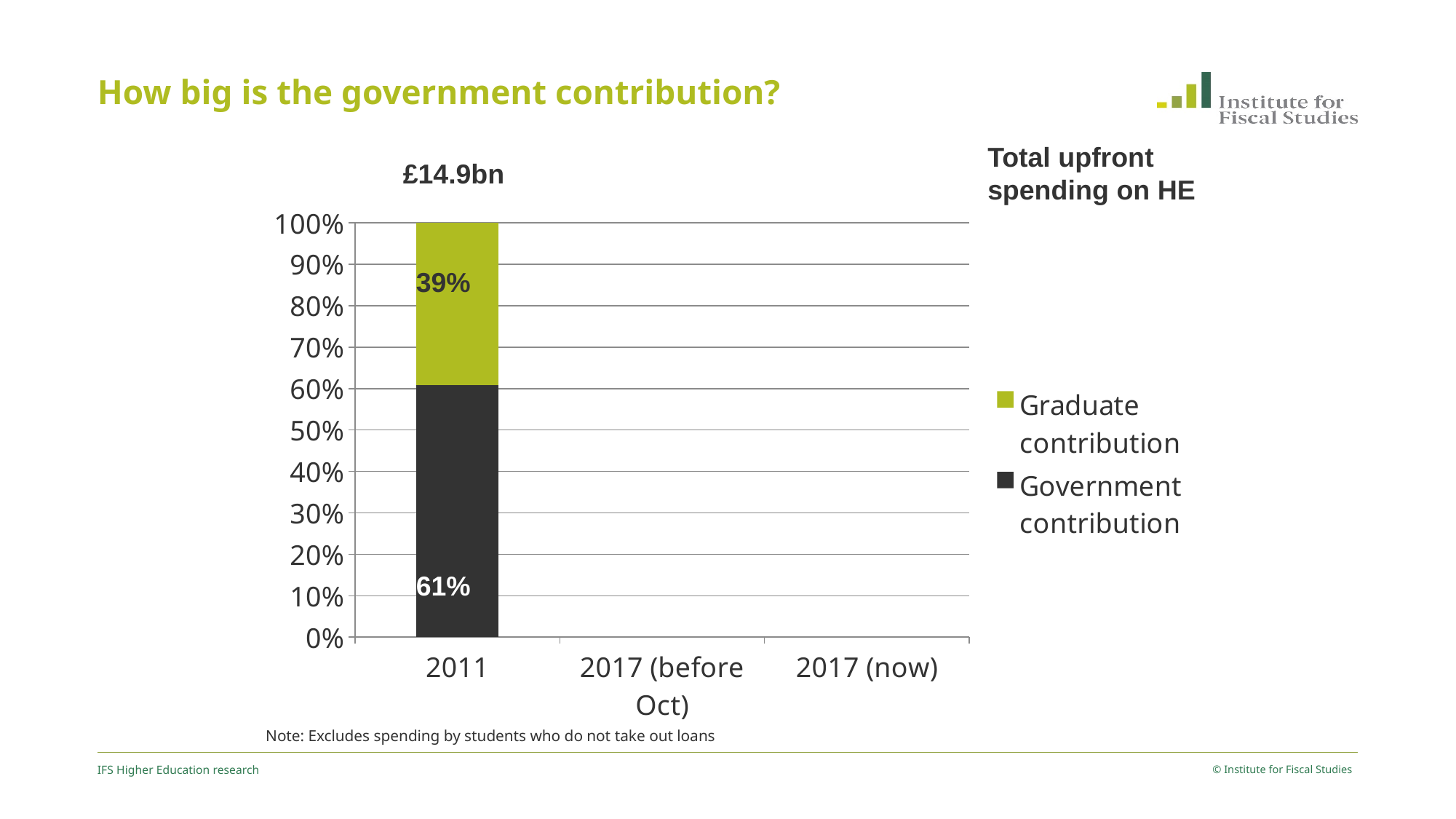
How many series does the legend list? 2 Which series is shown in green in the legend? Graduate contribution What kind of chart is shown on the slide? Stacked bar chart Is the government contribution for 2011 greater or less than 50%? greater Which is larger for 2011, the government contribution or the graduate contribution? Government contribution What is the government contribution share for 2011? 61% Is the graduate contribution for 2011 greater or less than 40%? less What is the total upfront spending on HE shown above the 2011 bar? £14.9bn What is the graduate contribution share for 2011? 39% How many categories are shown on the x axis? 3 What is the total of the stacked bar for 2011? 100% What is the difference between the government contribution and the graduate contribution in 2011? 22%